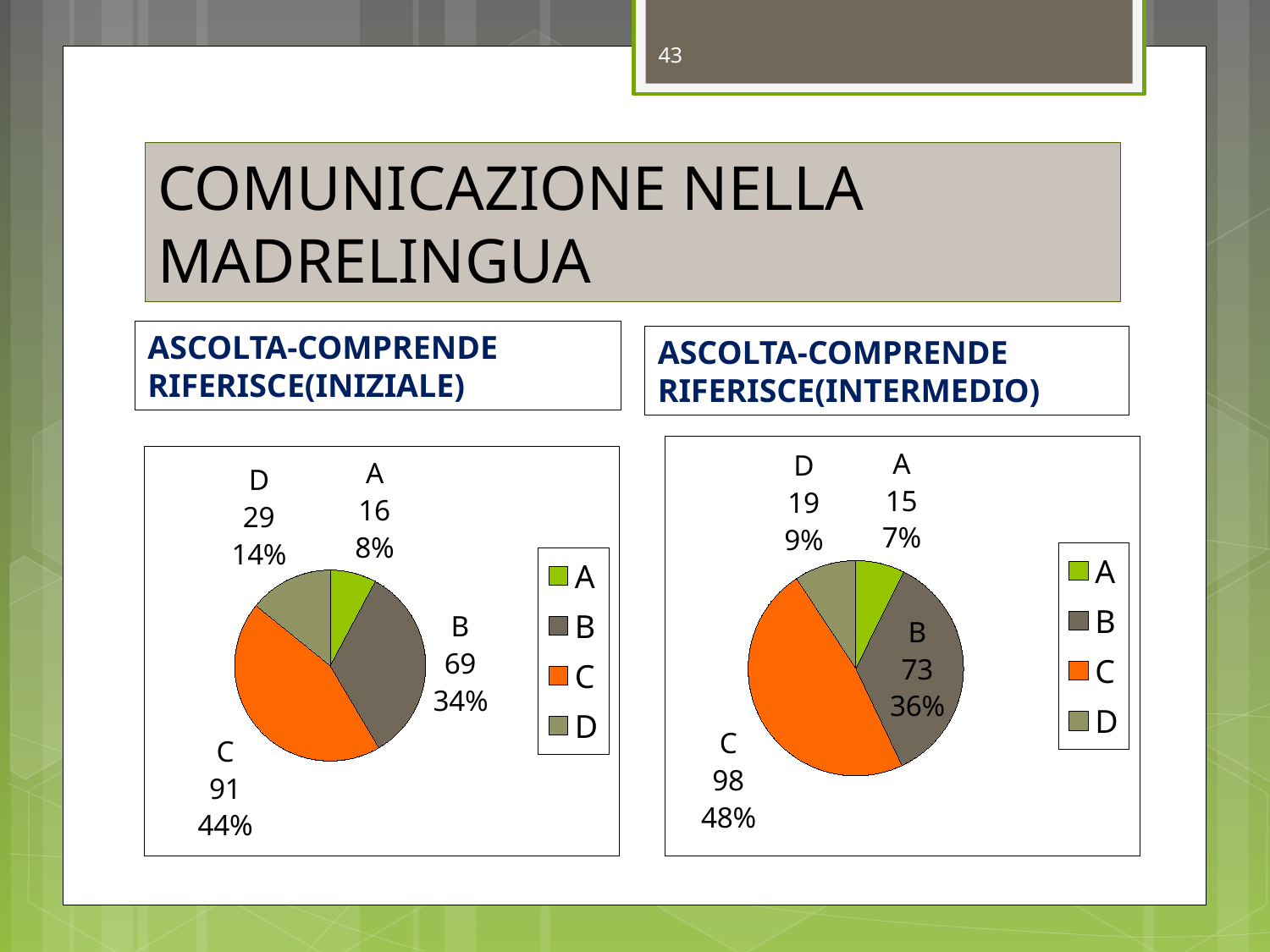
In the ASCOLTA-COMPRENDE RIFERISCE(INIZIALE) chart, what is the difference between the values for C and B? 22 In the ASCOLTA-COMPRENDE RIFERISCE(INTERMEDIO) chart, what share of the pie does C represent? 48% In the ASCOLTA-COMPRENDE RIFERISCE(INTERMEDIO) chart, which is larger, the value for B or the value for D? B In the ASCOLTA-COMPRENDE RIFERISCE(INTERMEDIO) chart, which category has the smallest slice? A What kind of chart is the ASCOLTA-COMPRENDE RIFERISCE(INTERMEDIO) chart? Pie chart In the ASCOLTA-COMPRENDE RIFERISCE(INIZIALE) chart, what is the value for C? 91 In the ASCOLTA-COMPRENDE RIFERISCE(INIZIALE) chart, what colour is the slice for C? Orange In the ASCOLTA-COMPRENDE RIFERISCE(INTERMEDIO) chart, what is the value for B? 73 How many categories does the ASCOLTA-COMPRENDE RIFERISCE(INIZIALE) chart show? 4 In the ASCOLTA-COMPRENDE RIFERISCE(INIZIALE) chart, which category has the largest slice? C In the ASCOLTA-COMPRENDE RIFERISCE(INIZIALE) chart, what share of the pie does D represent? 14% In the ASCOLTA-COMPRENDE RIFERISCE(INTERMEDIO) chart, what is the difference between the values for D and A? 4